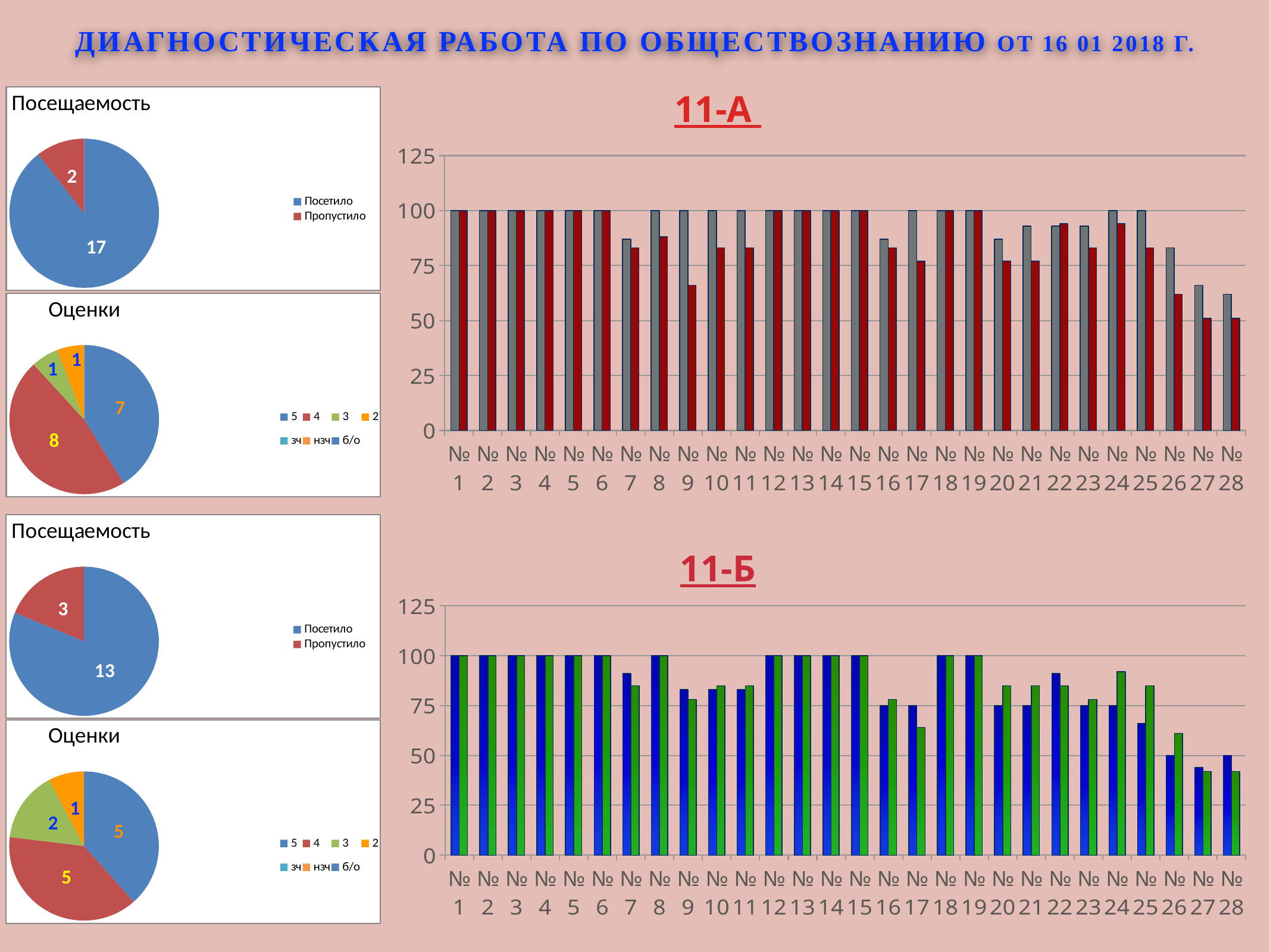
In the bottom 'Оценки' pie chart (for 11-Б), which grade has the smallest slice? 2 In the bottom 'Оценки' pie chart (for 11-Б), how many students received a grade of 3? 2 In the top 'Посещаемость' pie chart (for 11-А), what is the value for Пропустило? 2 In the '11-Б' bar chart, is the blue bar for № 27 greater or less than 50? less In the '11-А' bar chart, is the red bar for № 9 greater or less than 75? less In the bottom 'Посещаемость' pie chart (for 11-Б), what is the total of all slices? 16 In the bottom 'Посещаемость' pie chart (for 11-Б), what is the value for Пропустило? 3 In the top 'Оценки' pie chart (for 11-А), which grade has the largest slice? 4 In the top 'Оценки' pie chart (for 11-А), what is the difference between the number of grade 4 and grade 5? 1 In the top 'Посещаемость' pie chart (for 11-А), what is the value for Посетило? 17 What kind of chart is the '11-А' chart on the right? bar chart How many categories (№ 1 to № 28) are shown on the x axis of the '11-Б' bar chart? 28